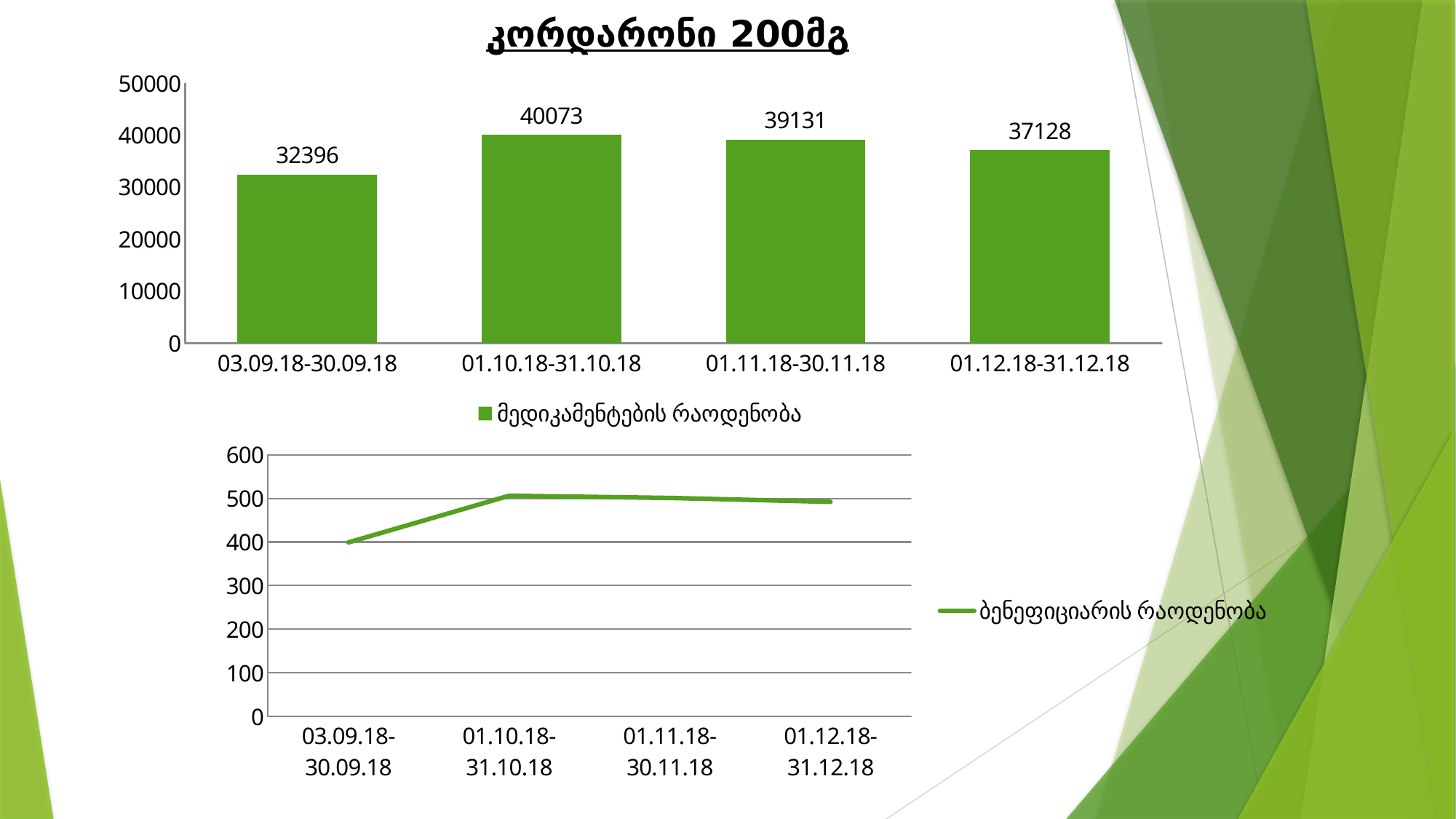
What type of chart is the top chart on the slide? Bar chart In the top bar chart, what is the difference between the values for 01.10.18-31.10.18 and 01.11.18-30.11.18? 942 In the top bar chart, which period has the lowest value? 03.09.18-30.09.18 In the top bar chart, what is the value for 03.09.18-30.09.18? 32396 In the top bar chart, which period has the highest value? 01.10.18-31.10.18 In the top bar chart, what is the value for 01.10.18-31.10.18? 40073 In the top bar chart, which is larger: the value for 01.11.18-30.11.18 or the value for 01.12.18-31.12.18? 01.11.18-30.11.18 In the bottom line chart, is the value for 03.09.18-30.09.18 greater or less than 500? less In the bottom line chart, is the value for 01.10.18-31.10.18 greater or less than 400? greater What is the legend entry of the bottom line chart? ბენეფიციარის რაოდენობა In the top bar chart, what is the value for 01.12.18-31.12.18? 37128 How many bars are in the top bar chart? 4